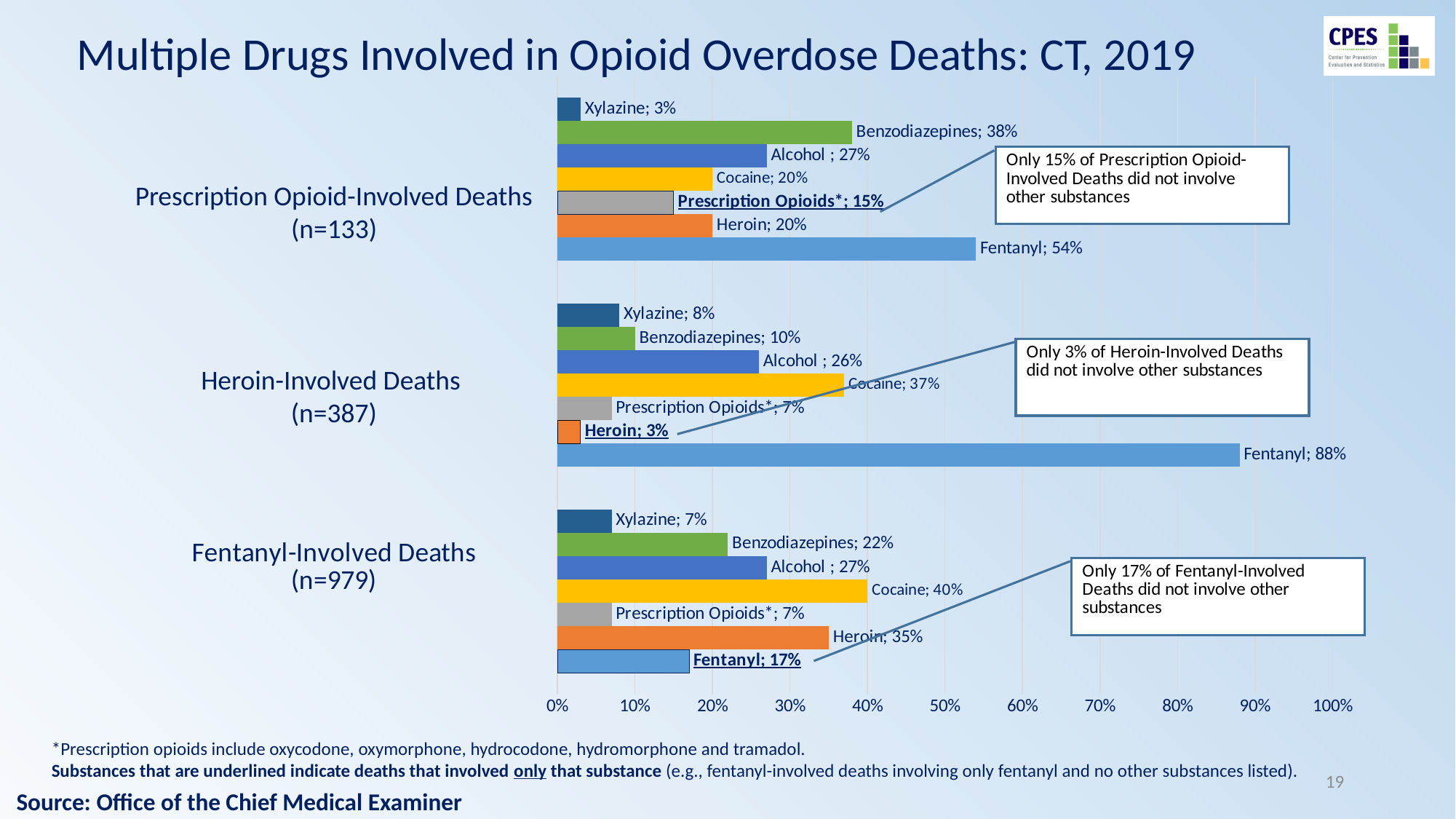
Which substance has the lowest percentage among Heroin-Involved Deaths? Heroin Which substance has the highest percentage among Prescription Opioid-Involved Deaths? Fentanyl Which is larger for Heroin-Involved Deaths: the Cocaine percentage or the Alcohol percentage? Cocaine What percentage of Fentanyl-Involved Deaths involved Cocaine? 40% What is the sample size (n) for Fentanyl-Involved Deaths? 979 What is the difference between the Cocaine percentage and the Heroin percentage for Fentanyl-Involved Deaths? 5% What is the title of the slide's chart? Multiple Drugs Involved in Opioid Overdose Deaths: CT, 2019 How many substance bars are shown for each death category? 7 What percentage of Heroin-Involved Deaths involved Fentanyl? 88% What percentage of Prescription Opioid-Involved Deaths involved Benzodiazepines? 38% How many death categories are shown on the chart? 3 What kind of chart is shown on the slide? Bar chart